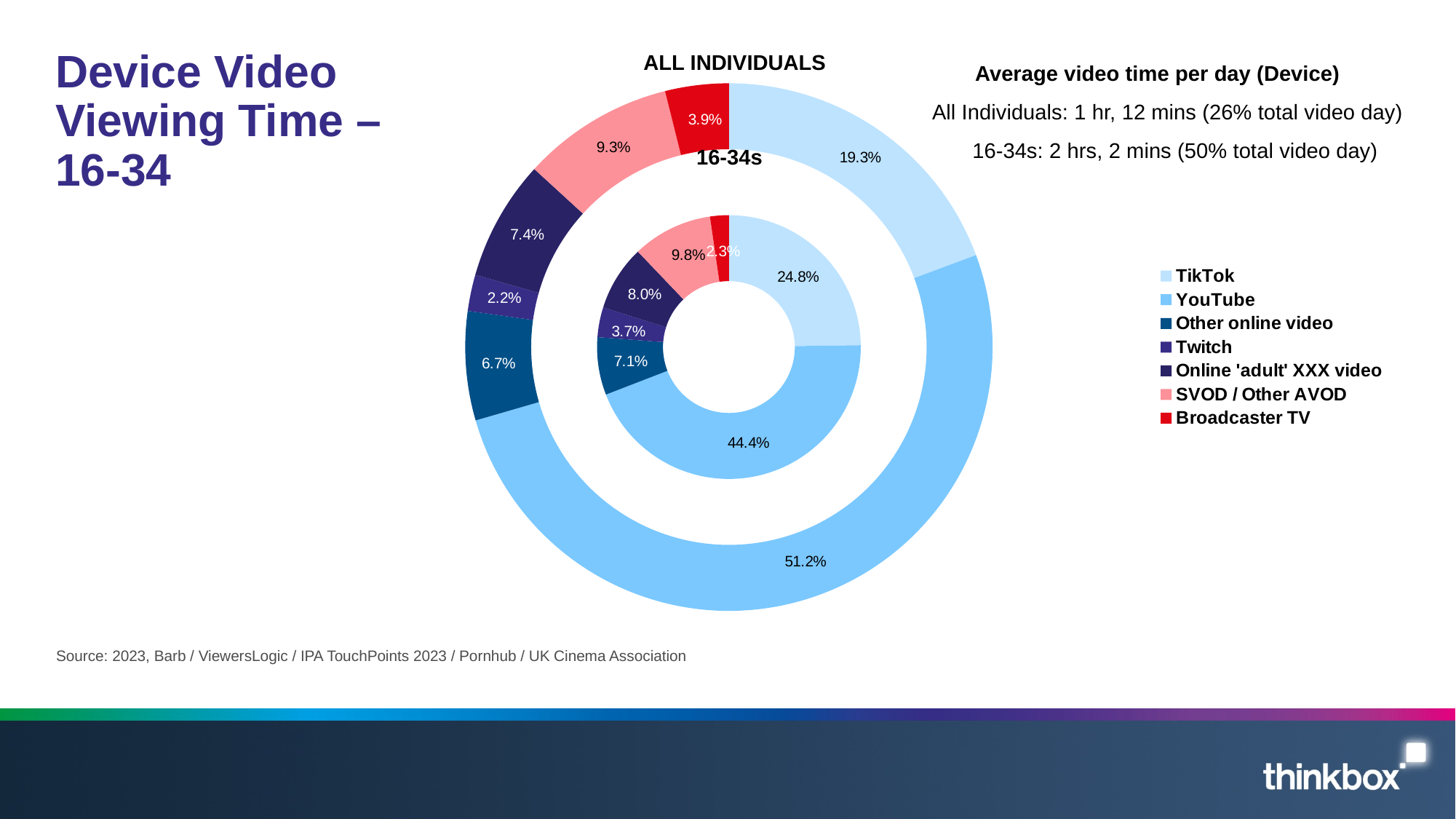
In the outer ring (All Individuals), what share does YouTube have? 51.2% In the inner ring (16-34s), what share does Broadcaster TV have? 2.3% Which category has the largest share in the outer ring (All Individuals)? YouTube Which is larger: the Twitch share for All Individuals or the Twitch share for 16-34s? 16-34s In the inner ring (16-34s), what share does TikTok have? 24.8% What is the difference between the TikTok share for 16-34s and the TikTok share for All Individuals? 5.5% How many categories does the legend list? 7 Which category has the smallest share in the inner ring (16-34s)? Broadcaster TV What kind of chart is shown on the slide? Doughnut chart In the outer ring (All Individuals), what share does SVOD / Other AVOD have? 9.3% Which category has the smallest share in the outer ring (All Individuals)? Twitch Which ring of the doughnut chart represents All Individuals, the inner or the outer? Outer